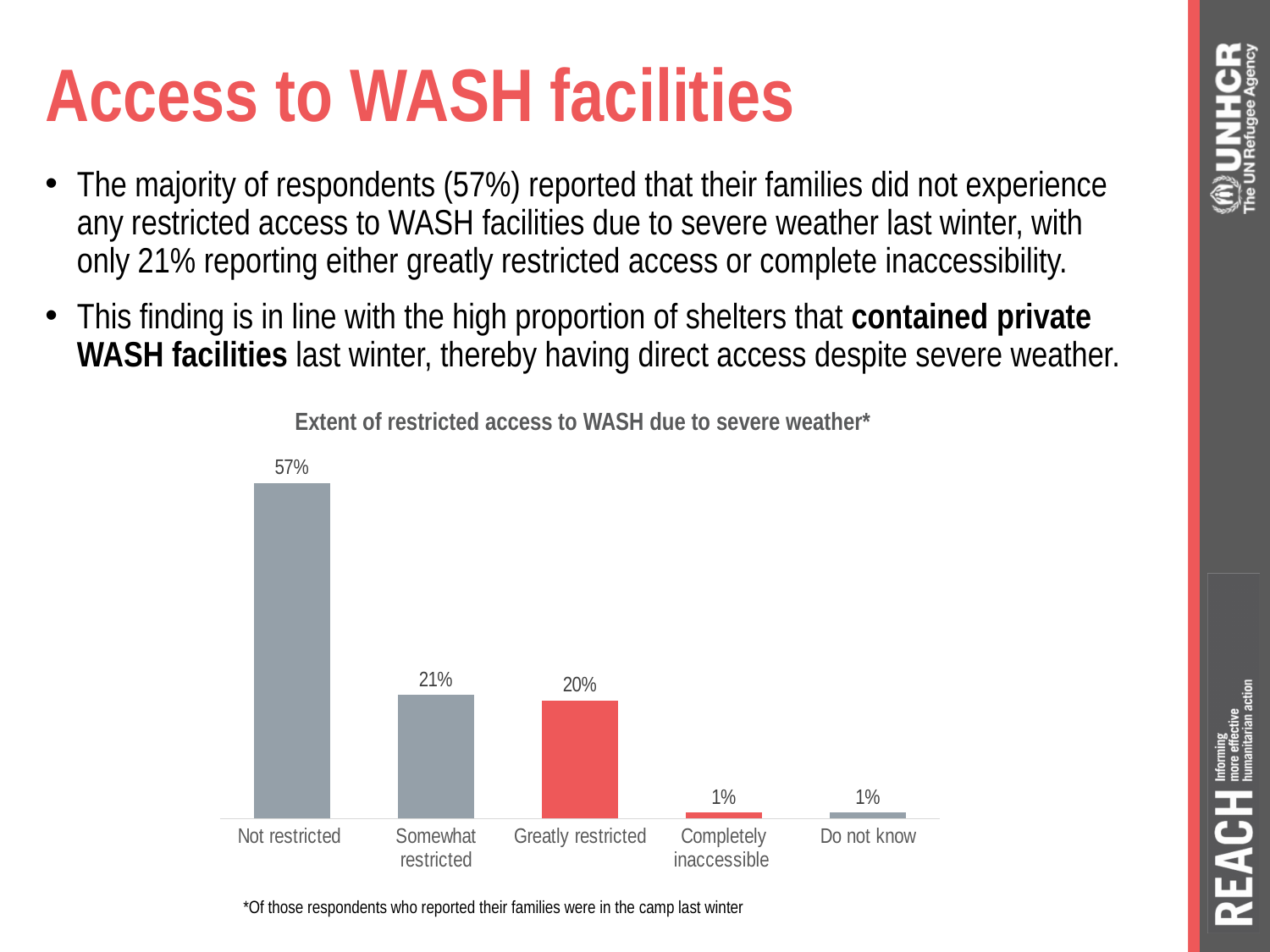
What is the value for Completely inaccessible? 1% What is the difference between the values for Somewhat restricted and Greatly restricted? 1% What is the difference between the values for Not restricted and Somewhat restricted? 36% What is the title of the chart? Extent of restricted access to WASH due to severe weather* Which two categories are shown with red bars? Greatly restricted and Completely inaccessible Which is larger, the value for Not restricted or the value for Greatly restricted? Not restricted What is the value for Not restricted? 57% What is the value for Somewhat restricted? 21% How many categories are shown in the chart? 5 Which category has the highest value? Not restricted What kind of chart is shown on the slide? Bar chart What is the value for Greatly restricted? 20%